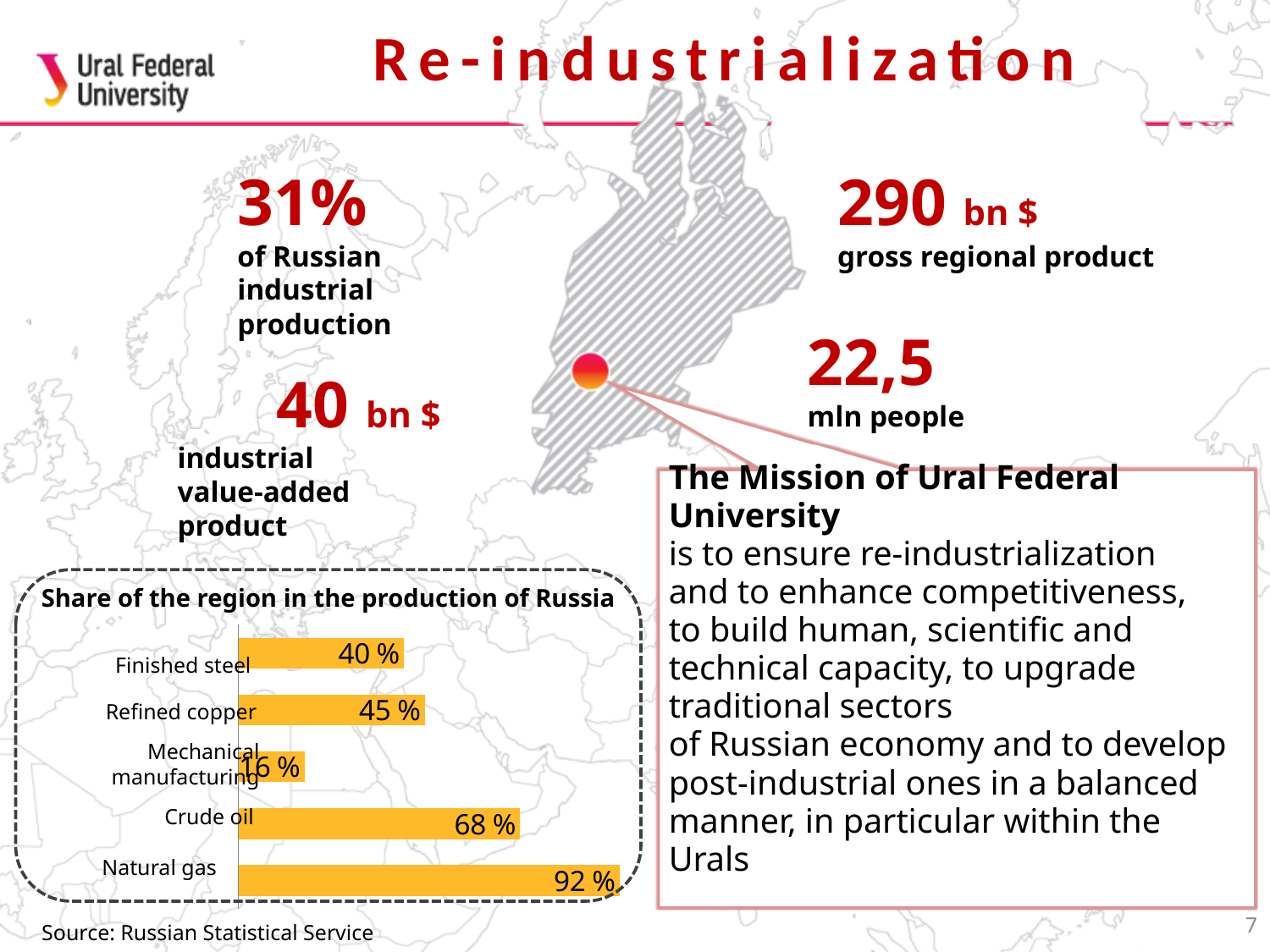
What is the value for Natural gas in the chart? 92 % What is the difference between the values for Natural gas and Crude oil? 24 % Which is larger, the value for Refined copper or the value for Finished steel? Refined copper Which category has the lowest value in the chart? Mechanical manufacturing Which category has the highest value in the chart? Natural gas What is the title of the chart? Share of the region in the production of Russia How many categories are shown in the chart? 5 What is the value for Crude oil in the chart? 68 % What is the value for Finished steel in the chart? 40 % What is the value for Refined copper in the chart? 45 % What kind of chart is shown on the slide? Bar chart What is the value for Mechanical manufacturing in the chart? 16 %